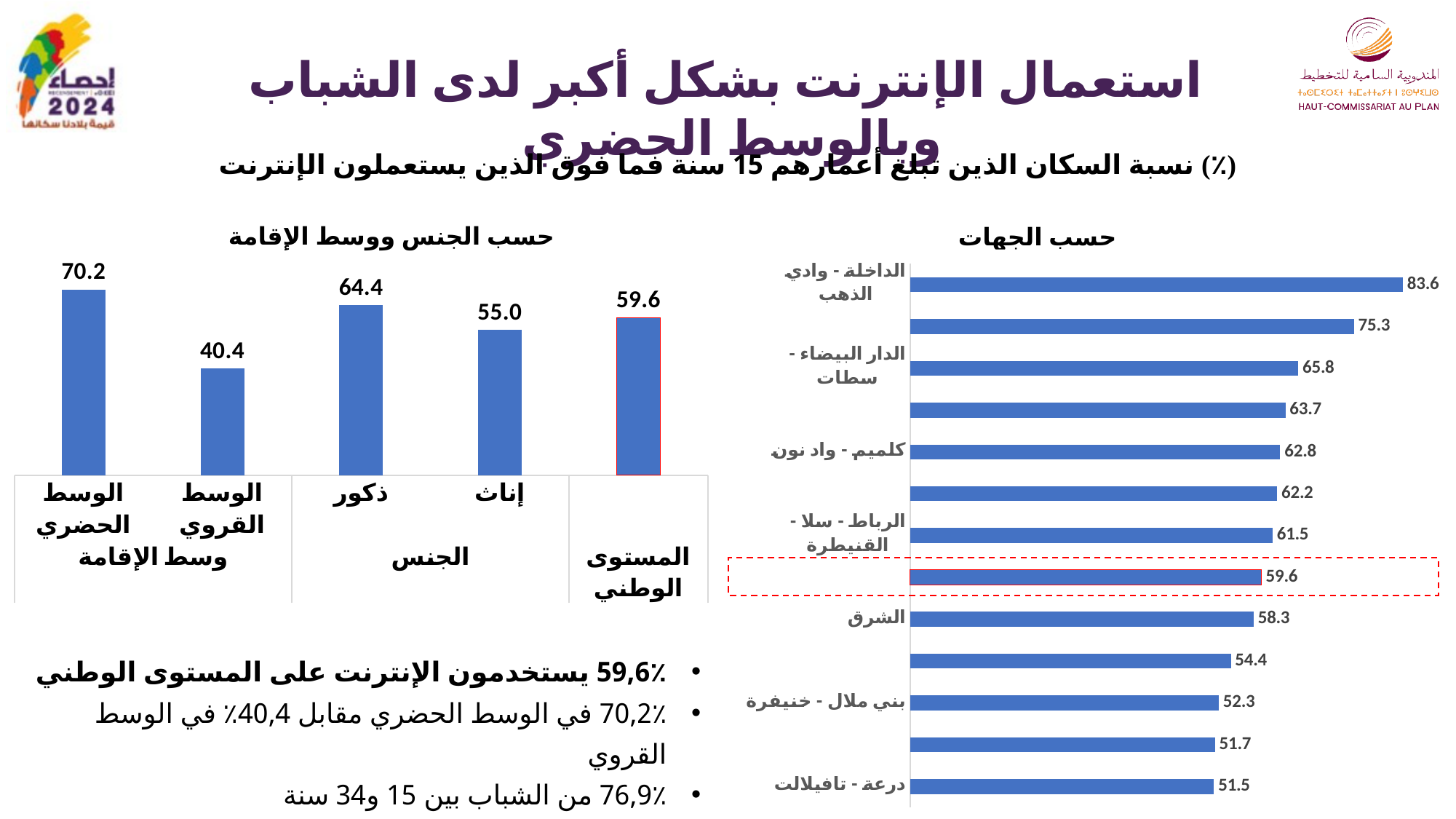
What kind of chart is the chart titled حسب الجهات? bar chart In the chart titled حسب الجنس ووسط الإقامة, what is the value for إناث? 55.0 In the chart titled حسب الجنس ووسط الإقامة, what is the difference between the values for ذكور and إناث? 9.4 In the chart titled حسب الجنس ووسط الإقامة, what is the value for المستوى الوطني? 59.6 In the chart titled حسب الجنس ووسط الإقامة, which category has the lowest value? الوسط القروي In the chart titled حسب الجهات, which is larger, the value for الشرق or the value for بني ملال - خنيفرة? الشرق In the chart titled حسب الجهات, what is the value for درعة - تافيلالت? 51.5 In the chart titled حسب الجهات, how many bars are plotted? 13 In the chart titled حسب الجهات, what is the value for الداخلة - وادي الذهب? 83.6 In the chart titled حسب الجنس ووسط الإقامة, how many bars are plotted? 5 In the chart titled حسب الجنس ووسط الإقامة, what is the value for الوسط الحضري? 70.2 In the chart titled حسب الجهات, which region has the highest value? الداخلة - وادي الذهب